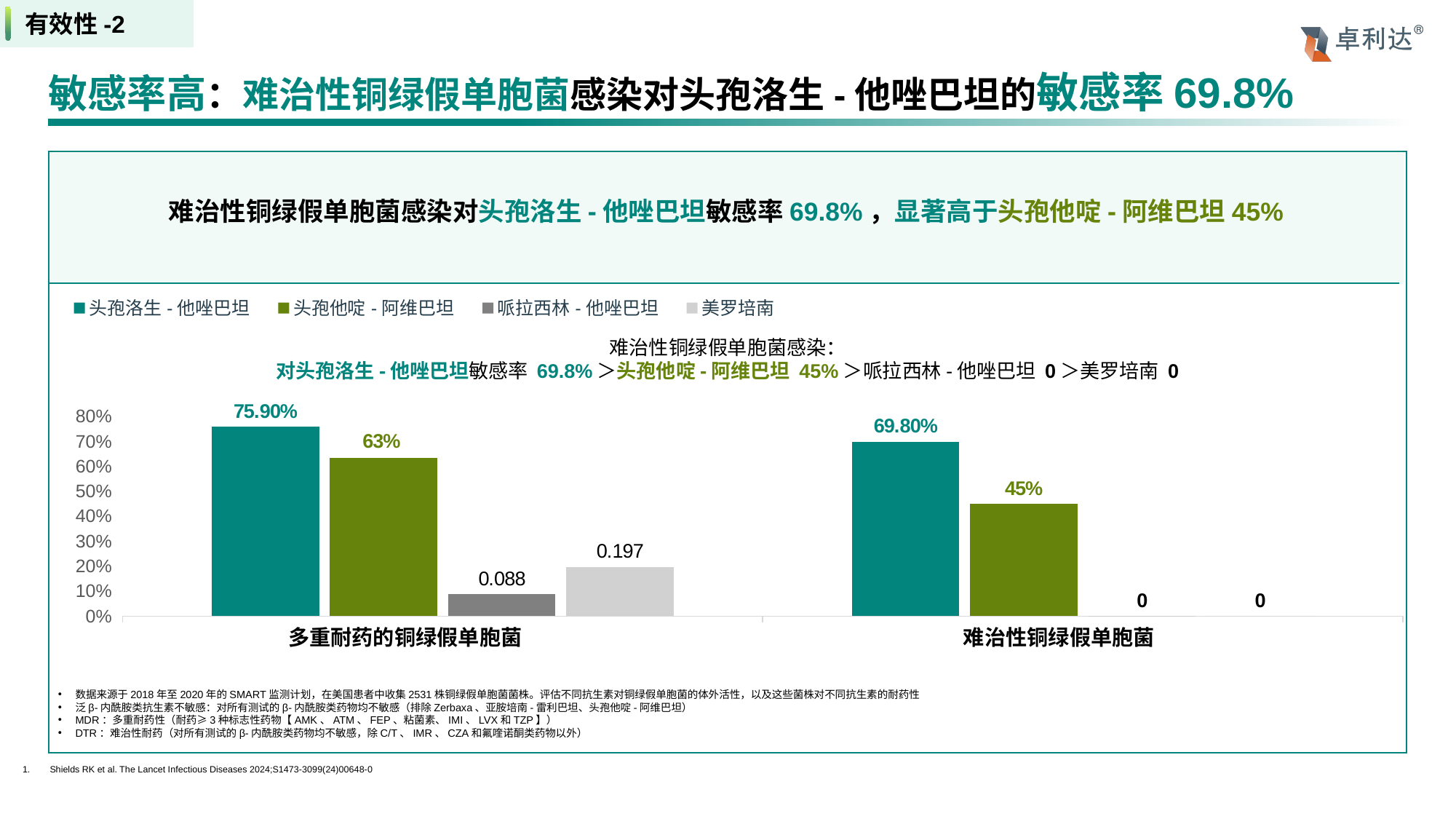
Which series has the highest value in the 难治性铜绿假单胞菌 category? 头孢洛生 - 他唑巴坦 What is the value for 美罗培南 in the 多重耐药的铜绿假单胞菌 category? 0.197 Which is larger: the value for 头孢洛生 - 他唑巴坦 or 头孢他啶 - 阿维巴坦 in the 难治性铜绿假单胞菌 category? 头孢洛生 - 他唑巴坦 What is the value for 哌拉西林 - 他唑巴坦 in the 多重耐药的铜绿假单胞菌 category? 0.088 What is the value for 头孢洛生 - 他唑巴坦 in the 多重耐药的铜绿假单胞菌 category? 75.90% What is the value for 美罗培南 in the 难治性铜绿假单胞菌 category? 0 How many series does the chart legend list? 4 How many categories are shown on the x axis of the chart? 2 What is the value for 头孢他啶 - 阿维巴坦 in the 难治性铜绿假单胞菌 category? 45% What type of chart is shown on the slide? bar chart Which series has the lowest value in the 多重耐药的铜绿假单胞菌 category? 哌拉西林 - 他唑巴坦 Which series is shown in the darkest teal colour in the chart legend? 头孢洛生 - 他唑巴坦